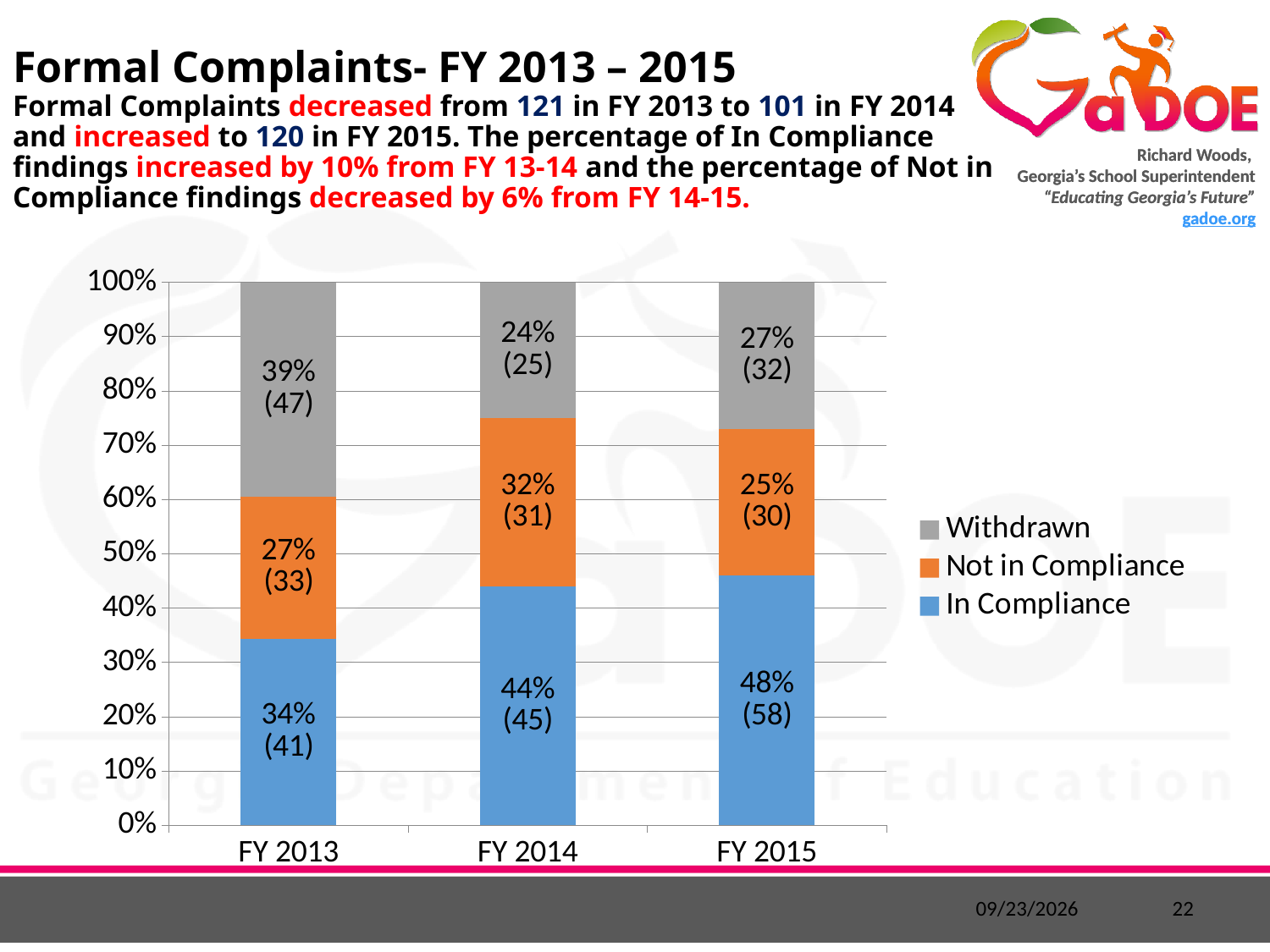
How many complaints were Withdrawn in FY 2014, according to the data label? 25 How many series does the legend list? 3 How many fiscal years are shown on the x axis? 3 Which fiscal year has the lowest Withdrawn percentage? FY 2014 Does the In Compliance percentage rise or fall from FY 2013 to FY 2015? Rise Which year had a larger Not in Compliance percentage, FY 2013 or FY 2014? FY 2014 What percentage of formal complaints were In Compliance in FY 2013? 34% What is the total number of complaints in FY 2015, summing the counts in the data labels? 120 What percentage of complaints were Not in Compliance in FY 2015? 25% By how many percentage points did the In Compliance share change from FY 2013 to FY 2014? 10 percentage points What kind of chart is shown on the slide? Stacked bar chart Which fiscal year has the highest In Compliance percentage? FY 2015